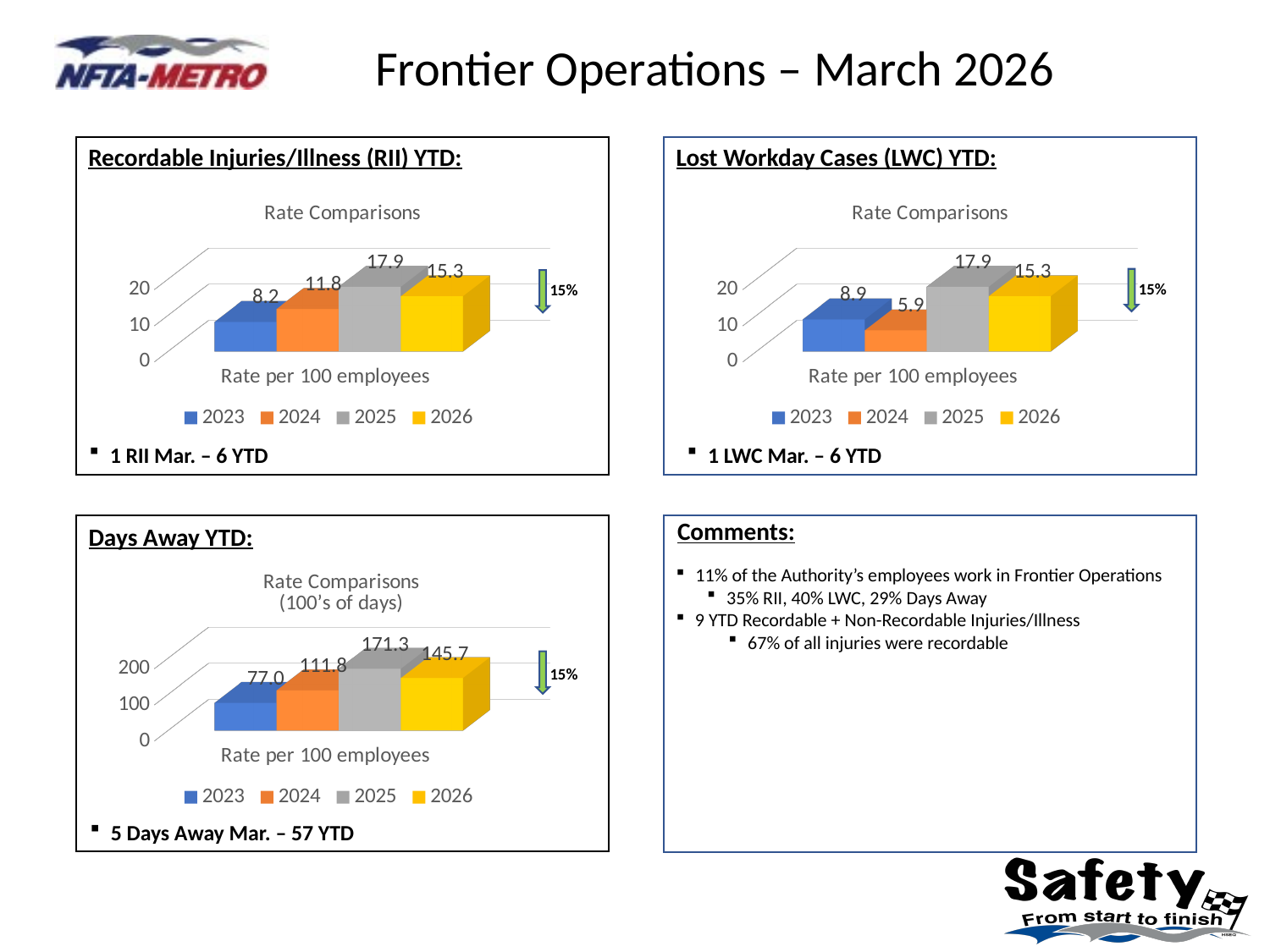
In the Days Away YTD chart, what is the value for 2025? 171.3 In the Lost Workday Cases (LWC) YTD chart, which year has the lowest value? 2024 In the Days Away YTD chart, is the value for 2023 greater or less than 100? less In the Recordable Injuries/Illness (RII) YTD chart, what is the difference between the 2025 and 2026 values? 2.6 In the Recordable Injuries/Illness (RII) YTD chart, which year has the highest value? 2025 In the Lost Workday Cases (LWC) YTD chart, what is the value for 2024? 5.9 What kind of chart is the Lost Workday Cases (LWC) YTD chart? Bar chart How many series does the legend of the Days Away YTD chart list? 4 In the Days Away YTD chart, what is the difference between the 2024 and 2023 values? 34.8 What is the title of the chart in the Recordable Injuries/Illness (RII) YTD box? Rate Comparisons In the Lost Workday Cases (LWC) YTD chart, which is larger, the value for 2023 or the value for 2024? 2023 In the Recordable Injuries/Illness (RII) YTD chart, what is the value for 2023? 8.2